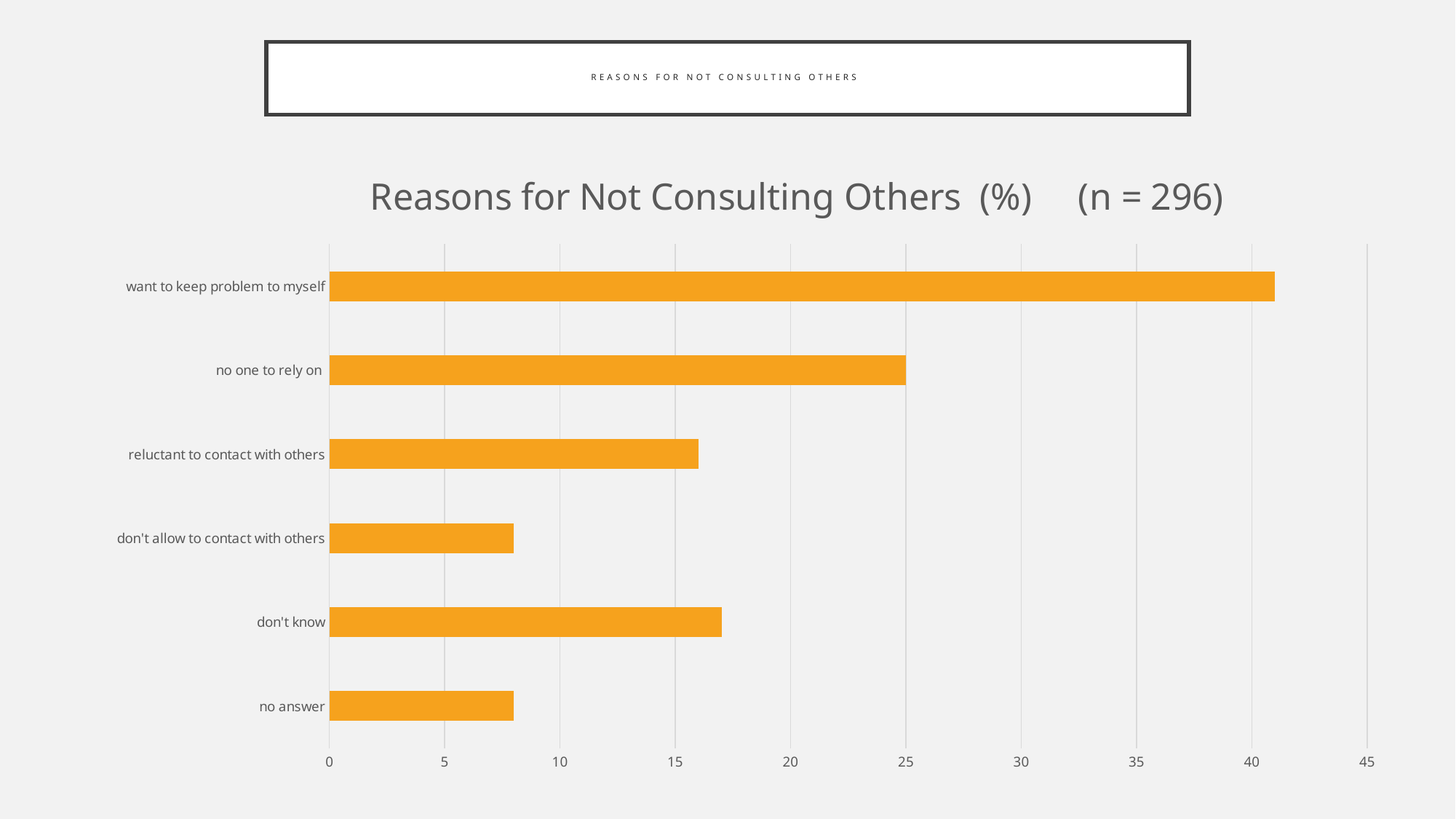
What type of chart is shown on the slide? bar chart Is the value for 'reluctant to contact with others' greater or less than 20? less How many reasons (categories) are plotted in the chart? 6 Which reason has the highest percentage? want to keep problem to myself Is the value for 'want to keep problem to myself' greater or less than 40? greater Is the value for 'don't know' greater or less than 15? greater Which is larger, the value for 'want to keep problem to myself' or 'no one to rely on'? want to keep problem to myself What is the value for 'no one to rely on'? 25 Which is larger, the value for 'no one to rely on' or 'don't know'? no one to rely on What sample size (n) is given in the chart title? 296